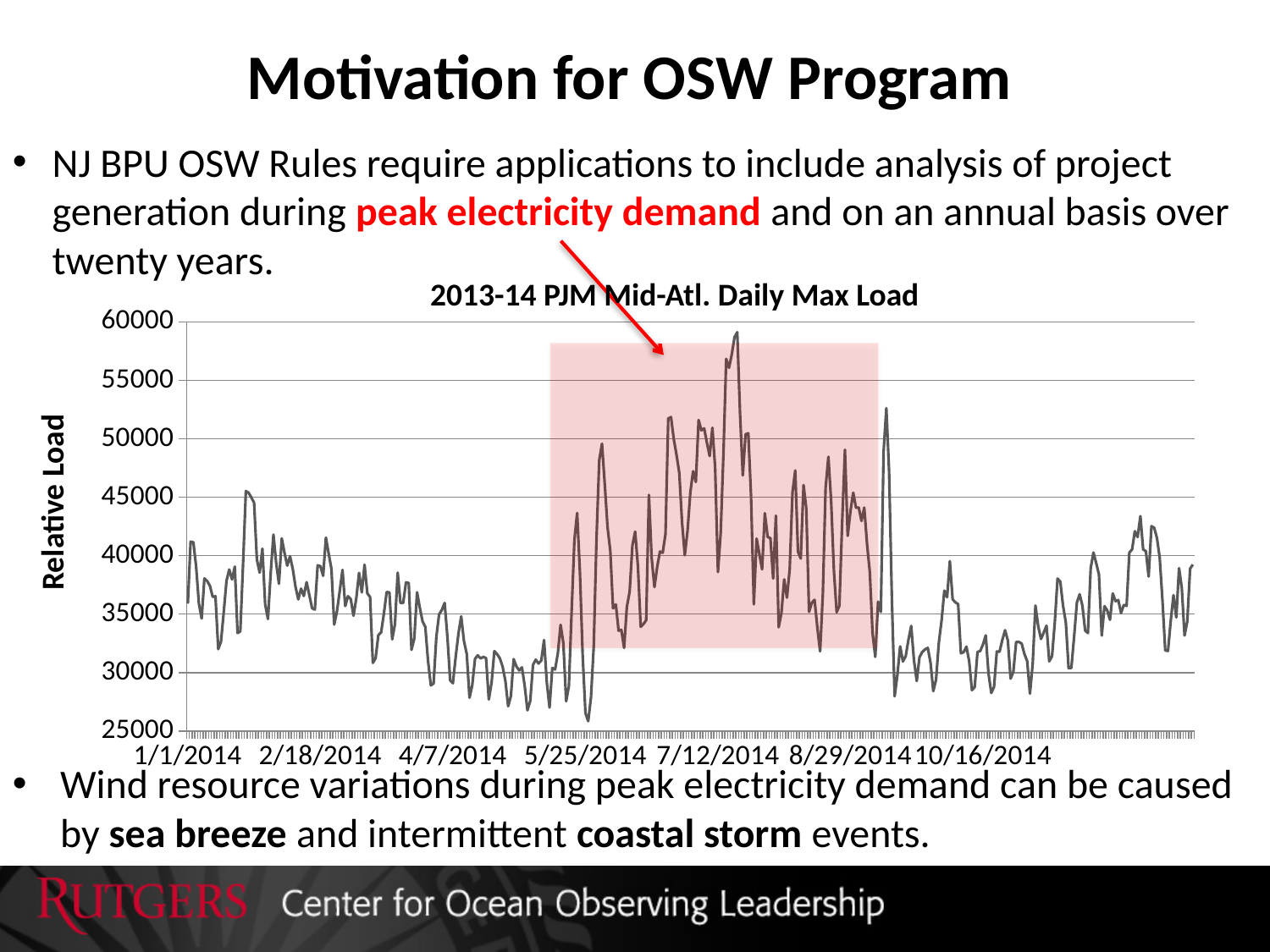
Is the highest peak of the line greater or less than 55000? greater How many date labels are shown on the horizontal axis? 7 How many series are plotted in the chart? 1 What is the lowest tick value shown on the vertical axis? 25000 What is the title of the chart? 2013-14 PJM Mid-Atl. Daily Max Load What is the first date label shown on the horizontal axis? 1/1/2014 What kind of chart is shown on the slide? line chart In which month does the line reach its highest peak? July 2014 Is the lowest point of the line greater or less than 30000? less What is the last date label shown on the horizontal axis? 10/16/2014 What is the highest tick value shown on the vertical axis? 60000 What is the label on the vertical axis of the chart? Relative Load